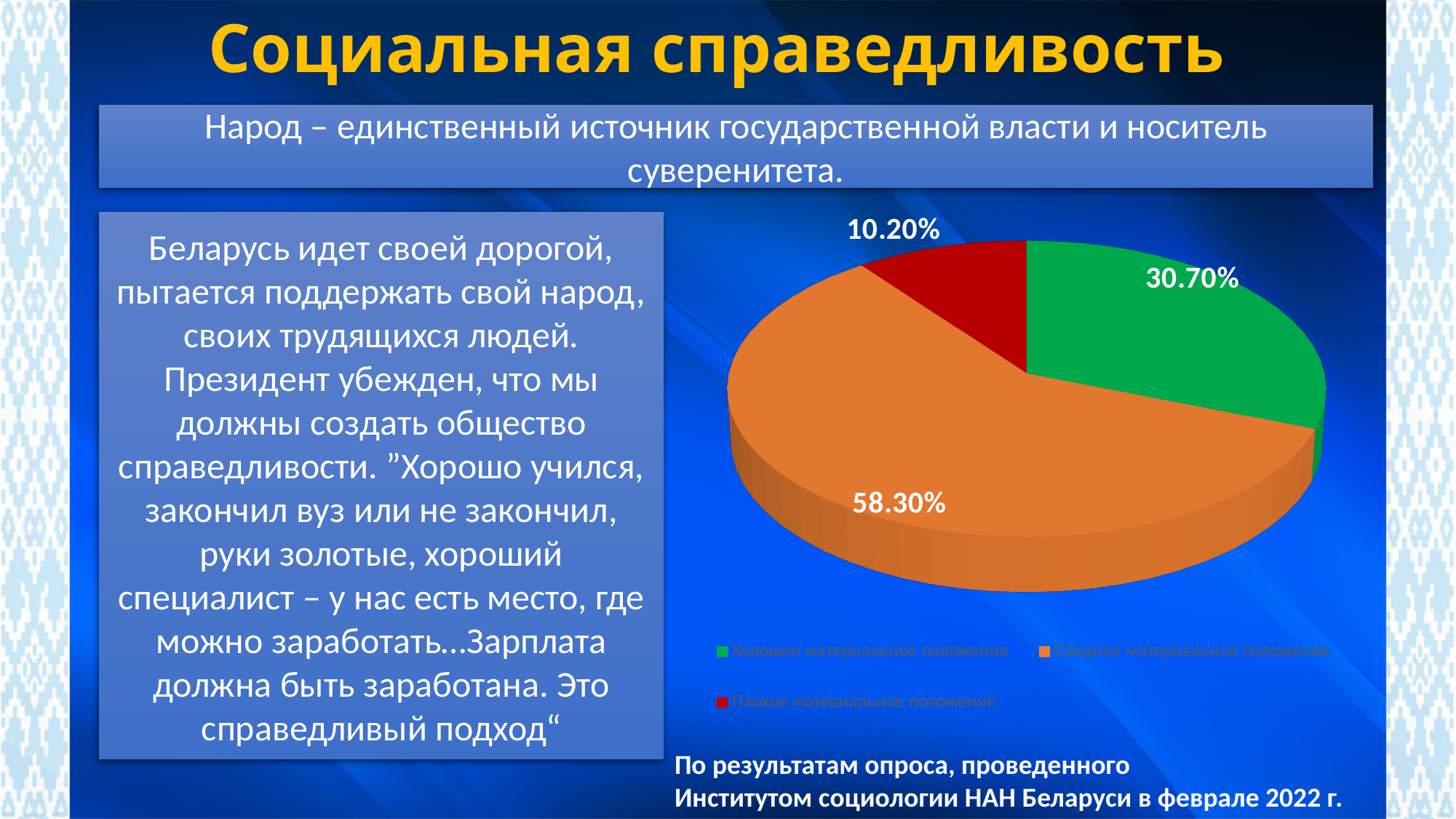
What colour is the slice for "Среднее материальное положение"? Orange Which category has the smallest slice of the pie? Плохое материальное положение What share of the pie is labelled for "Плохое материальное положение"? 10.20% What kind of chart is shown on the slide? Pie chart What is the difference in percentage points between the "Среднее материальное положение" slice and the "Хорошее материальное положение" slice? 27.60% What colour is the slice for "Плохое материальное положение"? Red Which is larger: the slice for "Хорошее материальное положение" or the slice for "Плохое материальное положение"? Хорошее материальное положение How many entries does the legend of the pie chart list? 3 What share of the pie is labelled for "Среднее материальное положение"? 58.30% What share of the pie is labelled for "Хорошее материальное положение"? 30.70% Which category has the largest slice of the pie? Среднее материальное положение How many slices does the pie chart have? 3